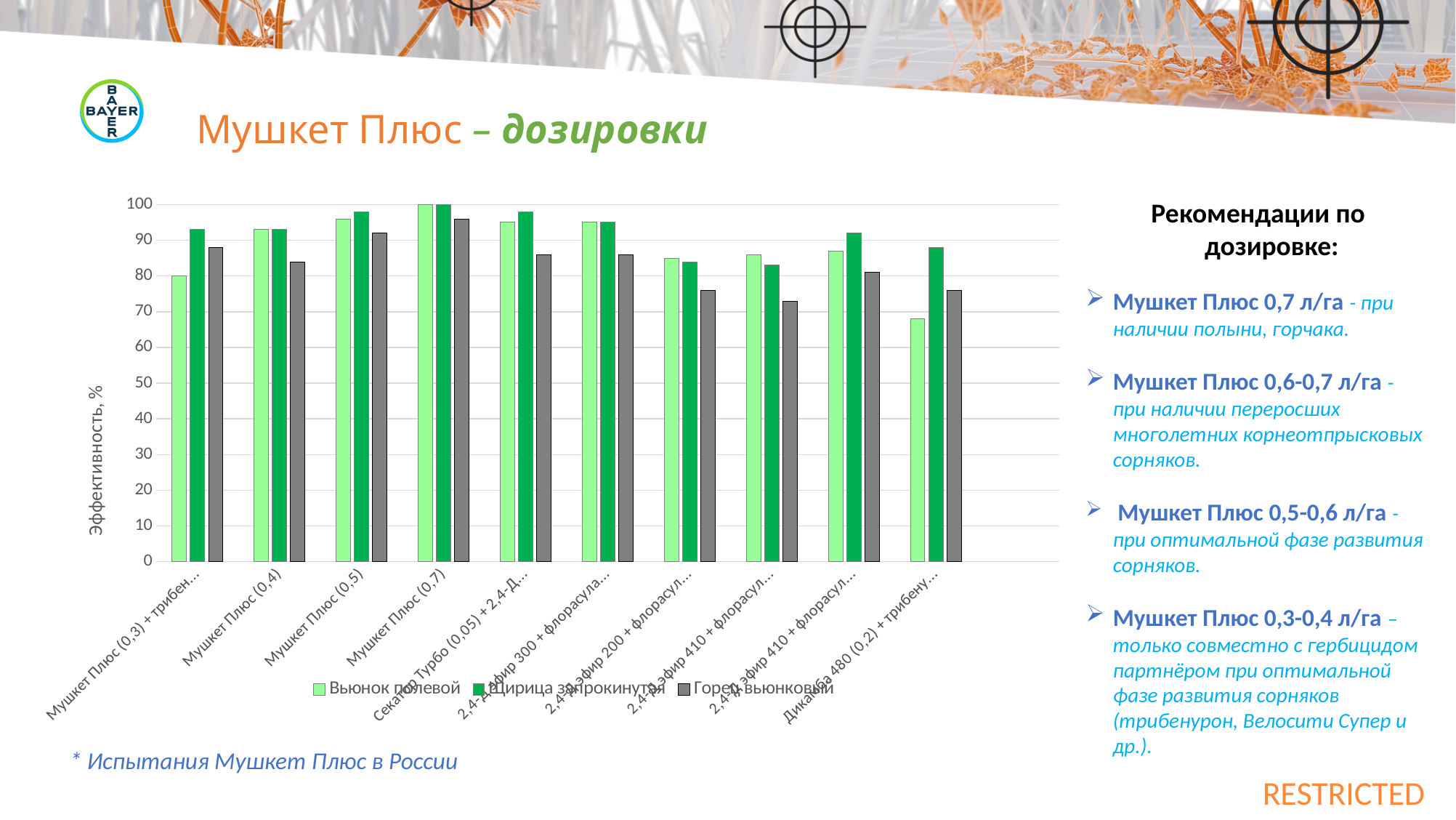
How many categories (treatment groups) are plotted along the x axis? 10 Is the value for Вьюнок полевой at Дикамба 480 (0,2) + трибену... greater or less than 70? less Which series is shown in dark green in the legend? Щирица запрокинутая What is the label of the vertical axis? Эффективность, % Is the value for Вьюнок полевой at Мушкет Плюс (0,7) greater or less than 90? greater How many series does the chart legend list? 3 Which category has the lowest value for Вьюнок полевой? Дикамба 480 (0,2) + трибену... Is the value for Горец вьюнковый at Мушкет Плюс (0,5) greater or less than 90? greater For Вьюнок полевой, which is larger: the value at Мушкет Плюс (0,7) or at Мушкет Плюс (0,4)? Мушкет Плюс (0,7) Which category has the highest value for Вьюнок полевой? Мушкет Плюс (0,7) What kind of chart is shown on the slide? bar chart